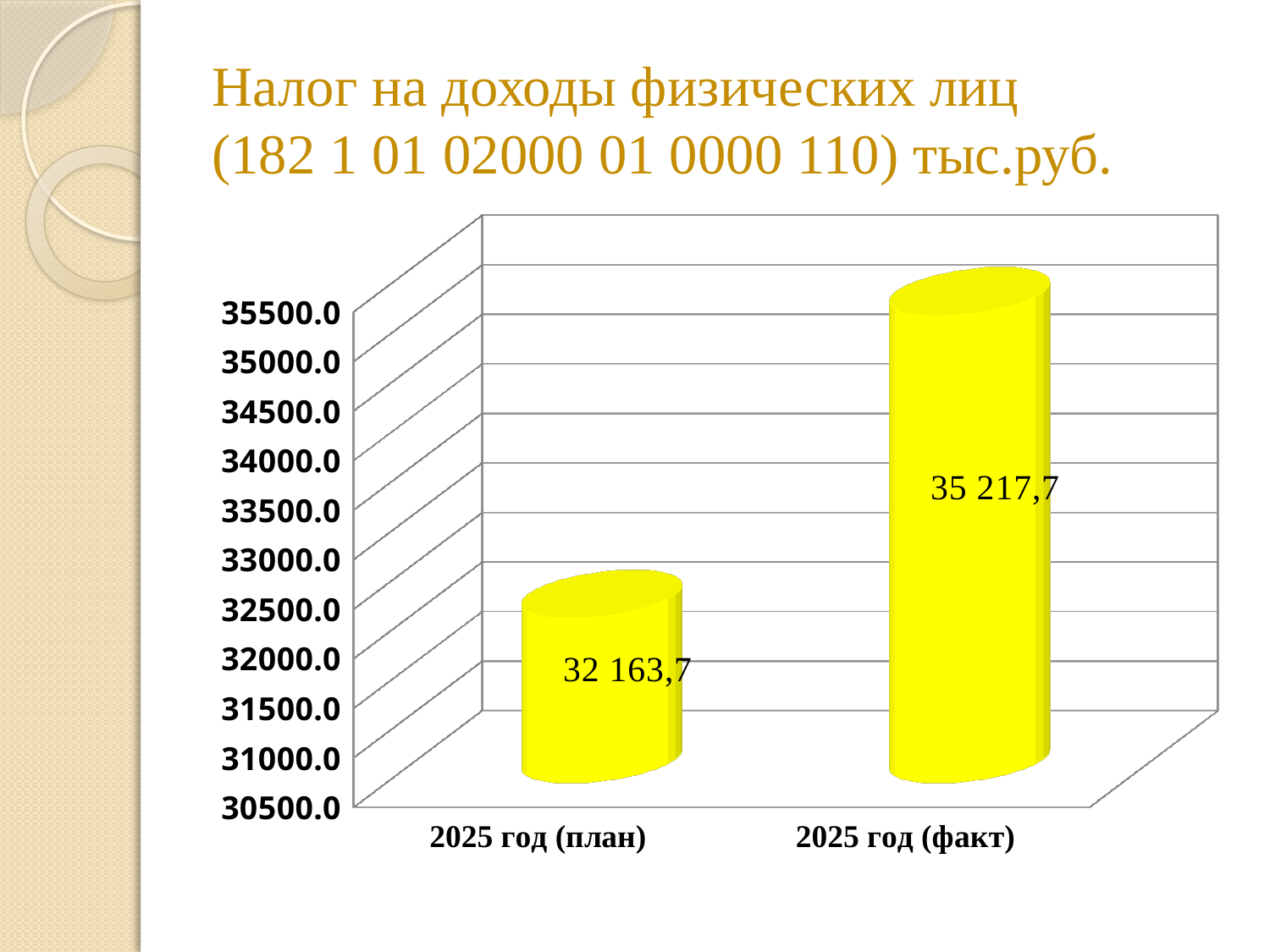
Is the value for 2025 год (план) greater or less than 33000? less What is the value for 2025 год (факт)? 35 217,7 What is the difference between the values for 2025 год (факт) and 2025 год (план)? 3 054,0 What is the value for 2025 год (план)? 32 163,7 How many categories are shown on the x axis? 2 Which is larger, the value for 2025 год (план) or the value for 2025 год (факт)? 2025 год (факт) In what units are the values on the chart expressed, according to the title? тыс.руб. What kind of chart is shown on the slide? bar chart Which category has the highest value? 2025 год (факт) Which category has the lowest value? 2025 год (план) Do the values rise or fall from 2025 год (план) to 2025 год (факт)? rise Is the value for 2025 год (факт) greater or less than 34000? greater